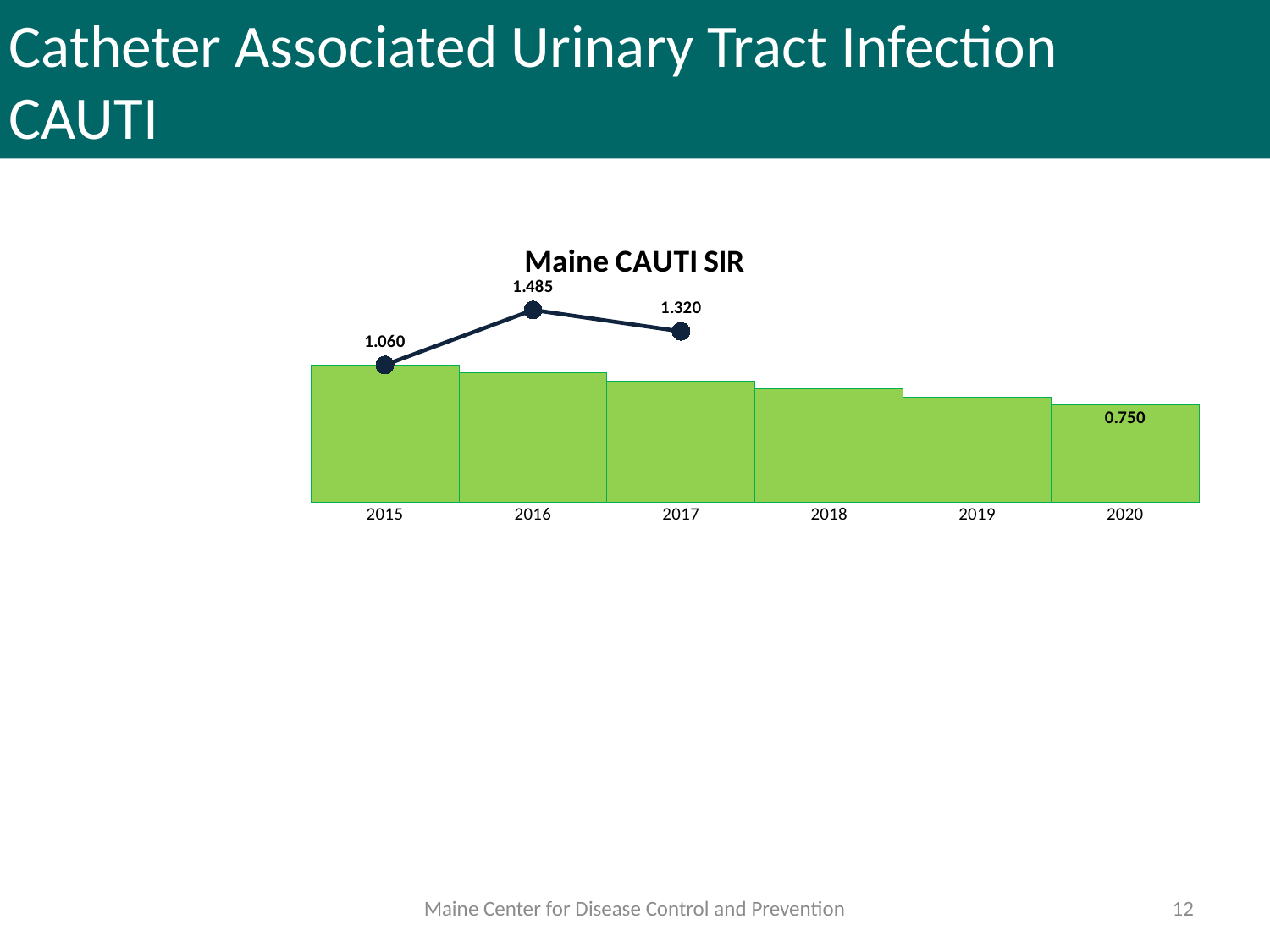
In the Maine CAUTI SIR chart, what is the value of the line data point for 2015? 1.060 In the Maine CAUTI SIR chart, which year has the lowest labeled line data point? 2015 In the Maine CAUTI SIR chart, which year has the highest line data point? 2016 What is the title of the chart on the slide? Maine CAUTI SIR How many years are shown on the x axis of the Maine CAUTI SIR chart? 6 In the Maine CAUTI SIR chart, what is the value of the line data point for 2017? 1.320 In the Maine CAUTI SIR chart, what is the difference between the line values for 2016 and 2015? 0.425 In the Maine CAUTI SIR chart, what is the value of the line data point for 2016? 1.485 In the Maine CAUTI SIR chart, what value is labeled on the bar for 2020? 0.750 In the Maine CAUTI SIR chart, do the green bars rise or fall from 2015 to 2020? fall In the Maine CAUTI SIR chart, what is the difference between the line values for 2016 and 2017? 0.165 In the Maine CAUTI SIR chart, which is larger: the line value for 2017 or the line value for 2015? 2017